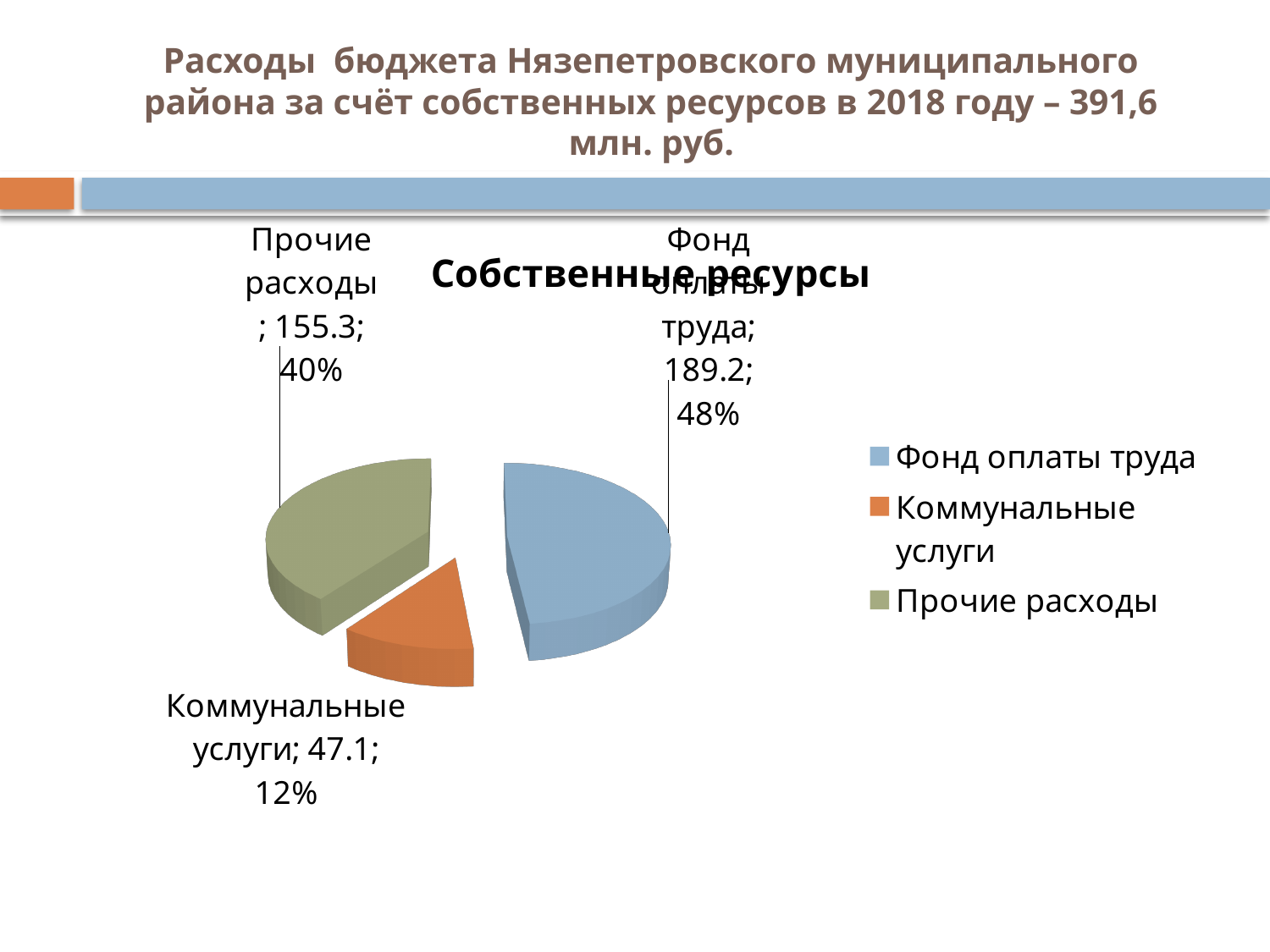
What share of the pie does Коммунальные услуги take? 12% Which category has the largest slice? Фонд оплаты труда What share of the pie does Фонд оплаты труда take? 48% Which is larger, Прочие расходы or Коммунальные услуги? Прочие расходы What is the value for Прочие расходы? 155.3 What is the title of the chart? Собственные ресурсы What is the difference between the values for Фонд оплаты труда and Прочие расходы? 33.9 How many slices does the pie chart have? 3 What is the value for Коммунальные услуги? 47.1 What is the value for Фонд оплаты труда? 189.2 Which category has the smallest slice? Коммунальные услуги What kind of chart is shown on the slide? pie chart